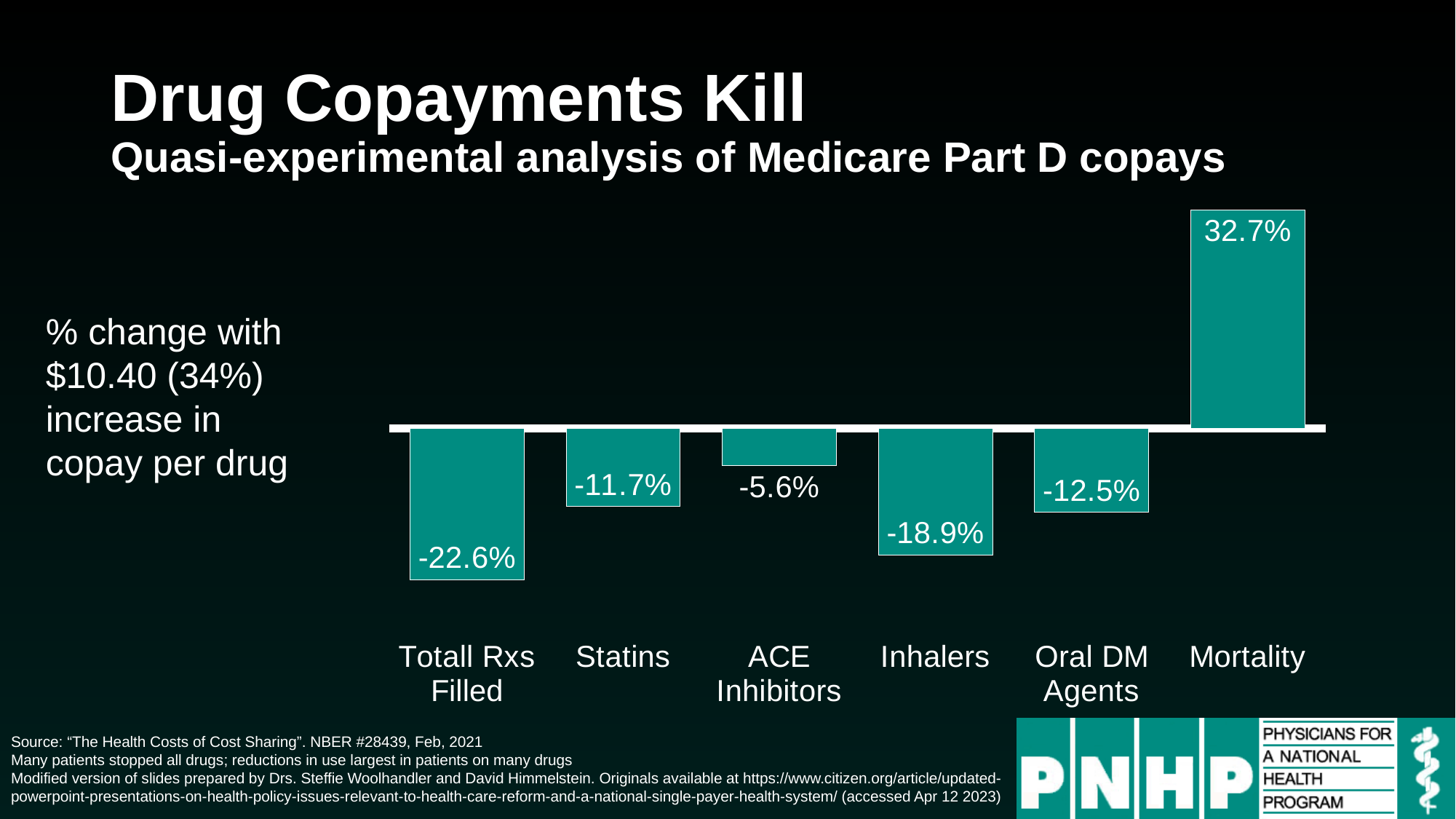
Which category has the highest value? Mortality Which category has the lowest value? Totall Rxs Filled Which has a larger decrease, Oral DM Agents or ACE Inhibitors? Oral DM Agents What is the % change for Oral DM Agents? -12.5% How many categories are shown in the chart? 6 What is the difference between the values for Inhalers and Statins? 7.2 percentage points What is the % change for ACE Inhibitors? -5.6% What is the % change for Statins? -11.7% What is the % change for Mortality? 32.7% What is the % change for Totall Rxs Filled? -22.6% What is the % change for Inhalers? -18.9% What kind of chart is shown on the slide? Bar chart